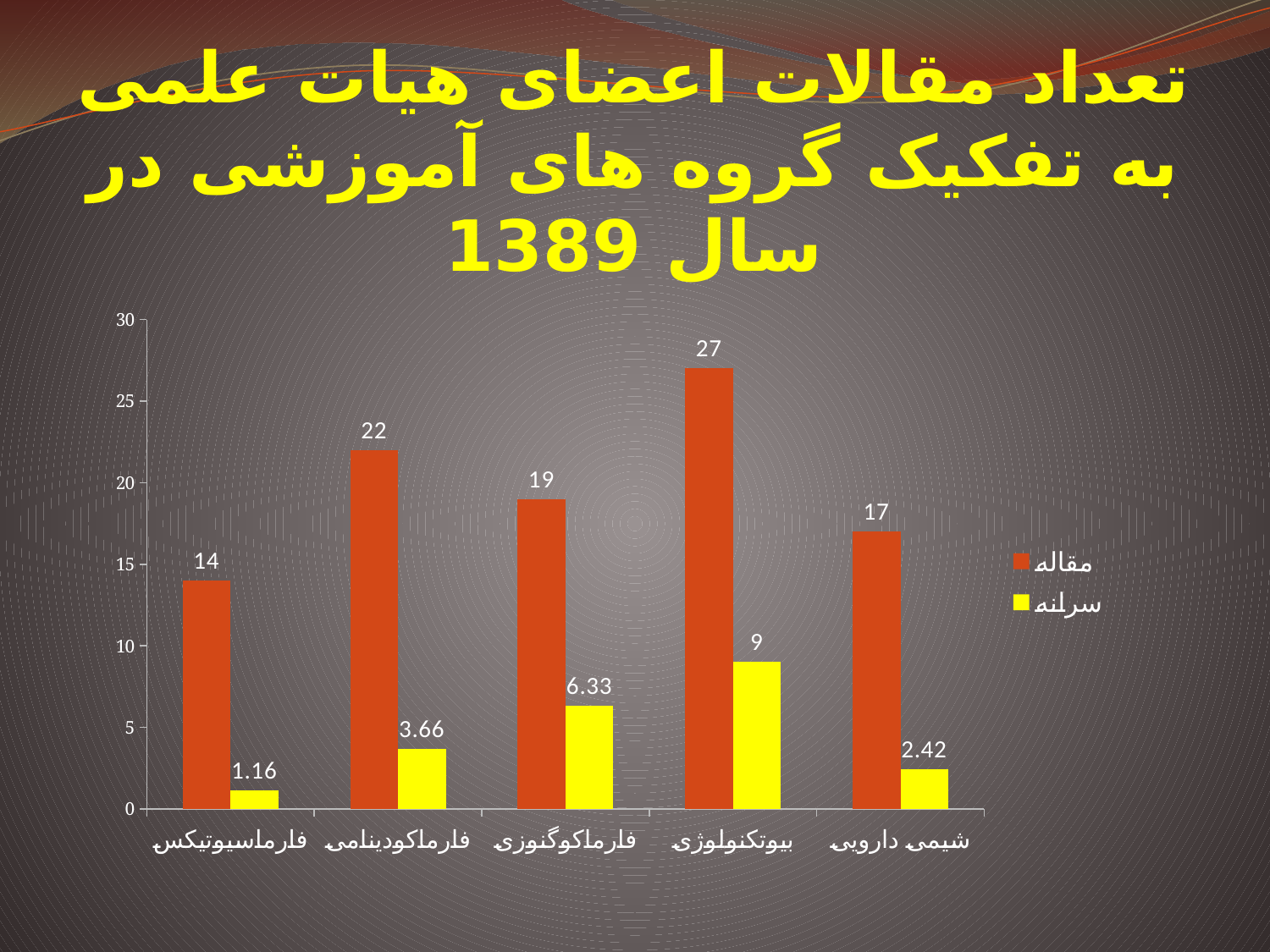
What is the value of سرانه for فارماسیوتیکس? 1.16 How many series does the legend list? 2 How many categories are shown on the x axis? 5 Which category has the lowest سرانه value? فارماسیوتیکس Which is larger, the مقاله value for فارماکودینامی or for فارماکوگنوزی? فارماکودینامی Is the مقاله value for شیمی دارویی greater or less than 20? less What kind of chart is shown on the slide? bar chart Which category has the highest مقاله value? بیوتکنولوژی What is the difference between the مقاله values for بیوتکنولوژی and فارماسیوتیکس? 13 Which colour represents the سرانه series? yellow What is the value of سرانه for فارماکوگنوزی? 6.33 What is the value of مقاله for بیوتکنولوژی? 27